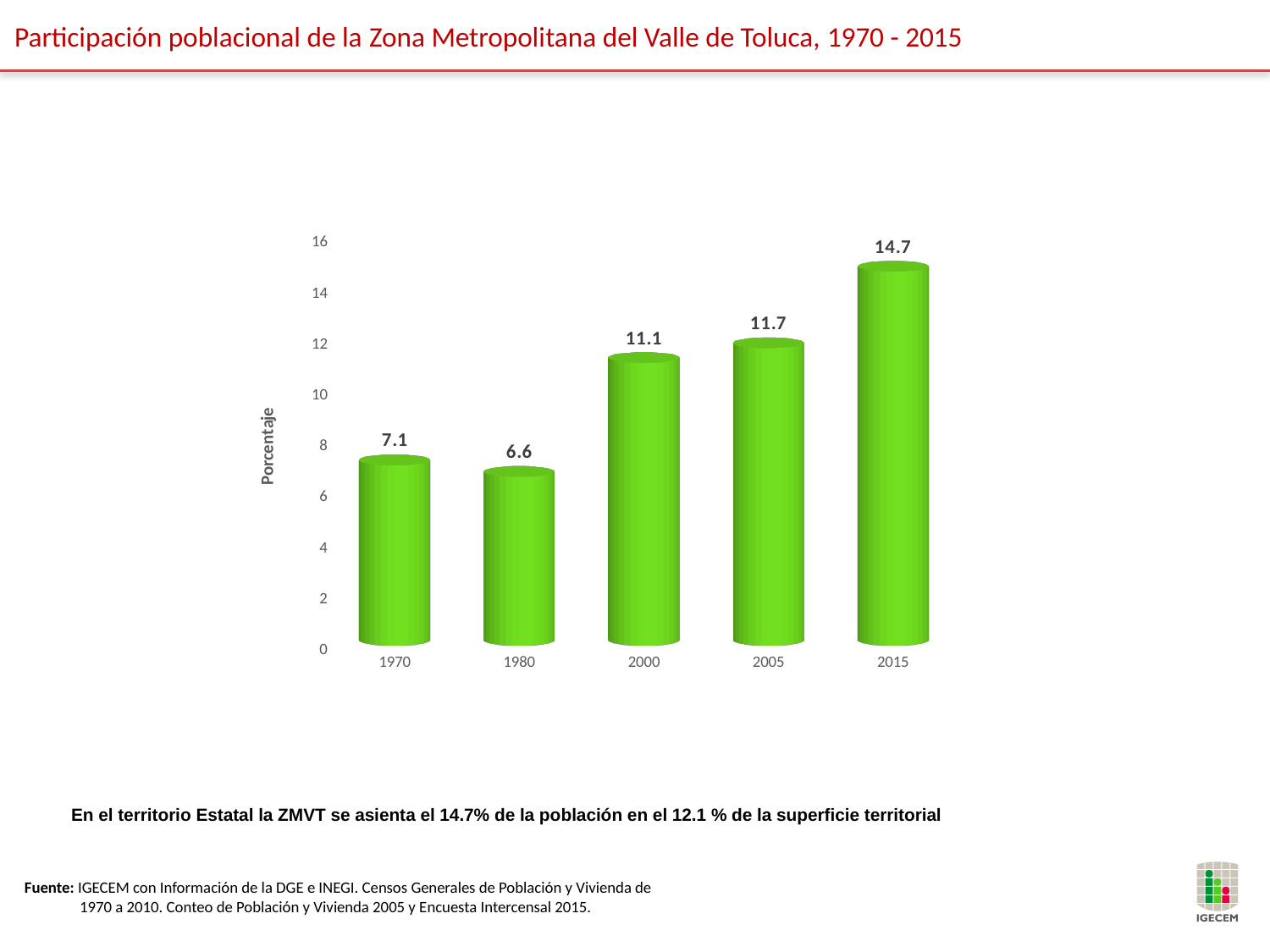
What is the value for 2015? 14.7 Is the value for 2005 greater or less than 10? greater Which year has the lowest value? 1980 What is the value for 2000? 11.1 What is the label of the vertical axis? Porcentaje Which is larger, the value for 1970 or the value for 1980? 1970 How many years are shown on the x axis? 5 Which year has the highest value? 2015 What is the difference between the values for 2005 and 2000? 0.6 What is the difference between the values for 2015 and 1970? 7.6 What is the value for 1970? 7.1 What kind of chart is shown on the slide? bar chart